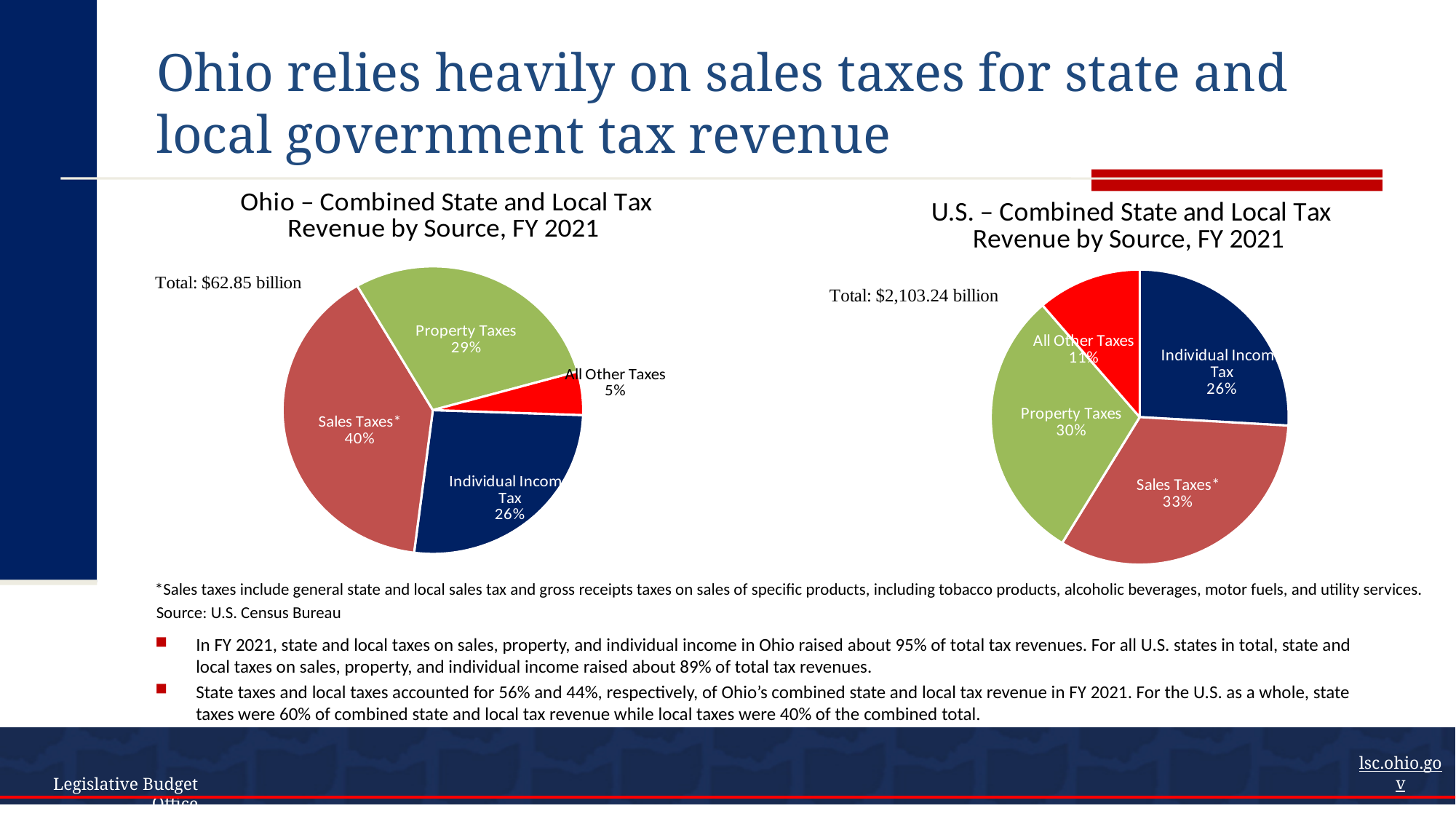
In the U.S. – Combined State and Local Tax Revenue by Source, FY 2021 chart, what share of revenue comes from Property Taxes? 30% What total revenue is shown next to the Ohio – Combined State and Local Tax Revenue by Source, FY 2021 chart? $62.85 billion In the U.S. chart on the right, what share of revenue comes from Individual Income Tax? 26% In the U.S. chart on the right, which is larger: the Sales Taxes share or the Individual Income Tax share? Sales Taxes In the Ohio chart on the left, what is the difference in percentage points between the Sales Taxes share and the Individual Income Tax share? 14 percentage points In the Ohio chart on the left, what share of revenue comes from All Other Taxes? 5% What kind of chart is used for the U.S. – Combined State and Local Tax Revenue by Source, FY 2021? Pie chart In the Ohio chart on the left, which source has the largest share of tax revenue? Sales Taxes In the U.S. chart on the right, which source has the smallest share of tax revenue? All Other Taxes What total revenue is shown next to the U.S. – Combined State and Local Tax Revenue by Source, FY 2021 chart? $2,103.24 billion How many slices does the Ohio – Combined State and Local Tax Revenue by Source, FY 2021 pie chart have? 4